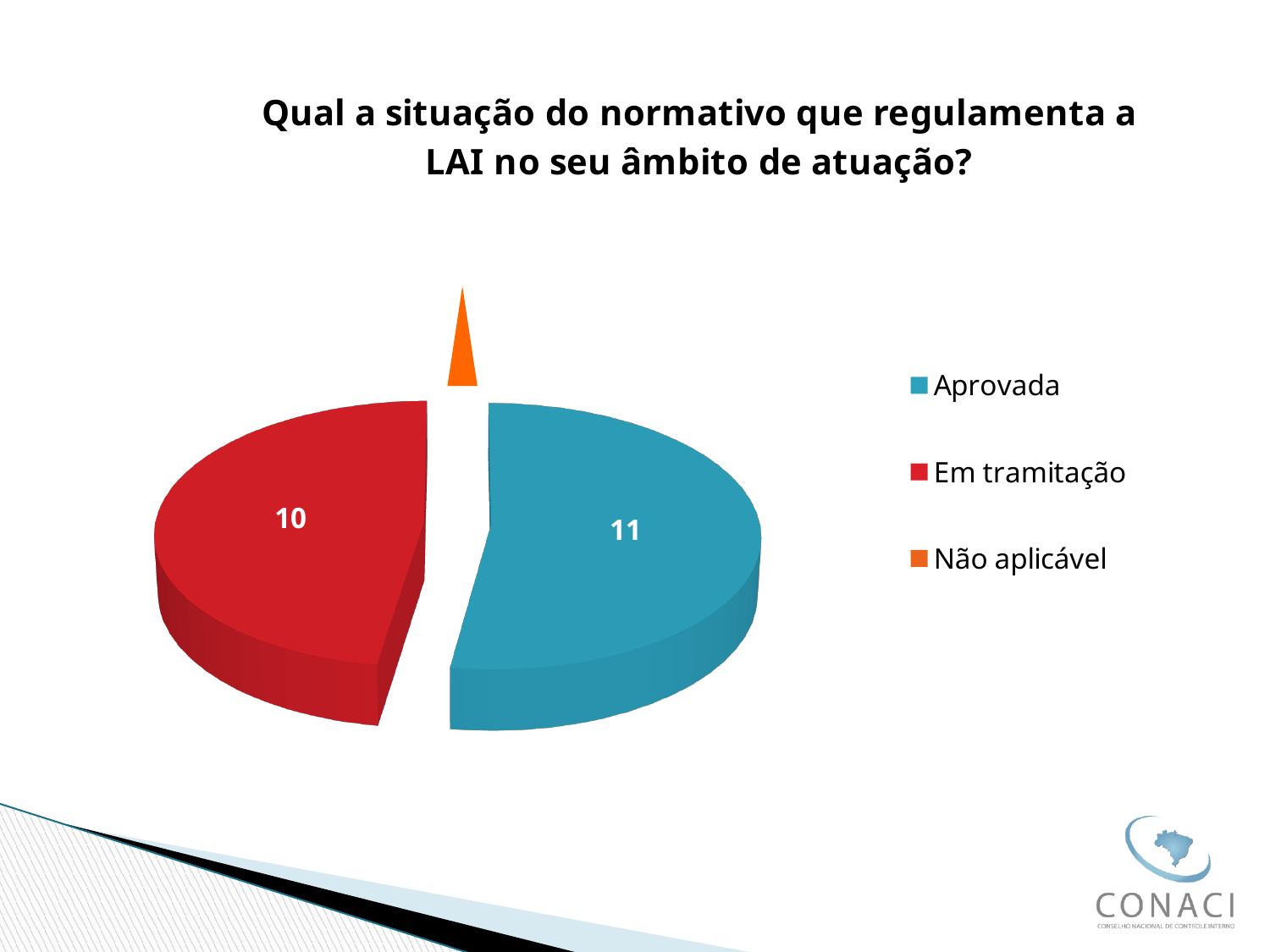
How many categories does the pie chart have? 3 What is the value for Aprovada? 11 How many entries does the legend list? 3 Which category has the smallest slice of the pie? Não aplicável Which is larger, the value for Aprovada or the value for Em tramitação? Aprovada What colour is the slice for Em tramitação? red What is the difference between the values for Aprovada and Em tramitação? 1 Which category has the largest slice of the pie? Aprovada What kind of chart is shown on the slide? pie chart What is the value for Em tramitação? 10 What is the title of the chart? Qual a situação do normativo que regulamenta a LAI no seu âmbito de atuação?